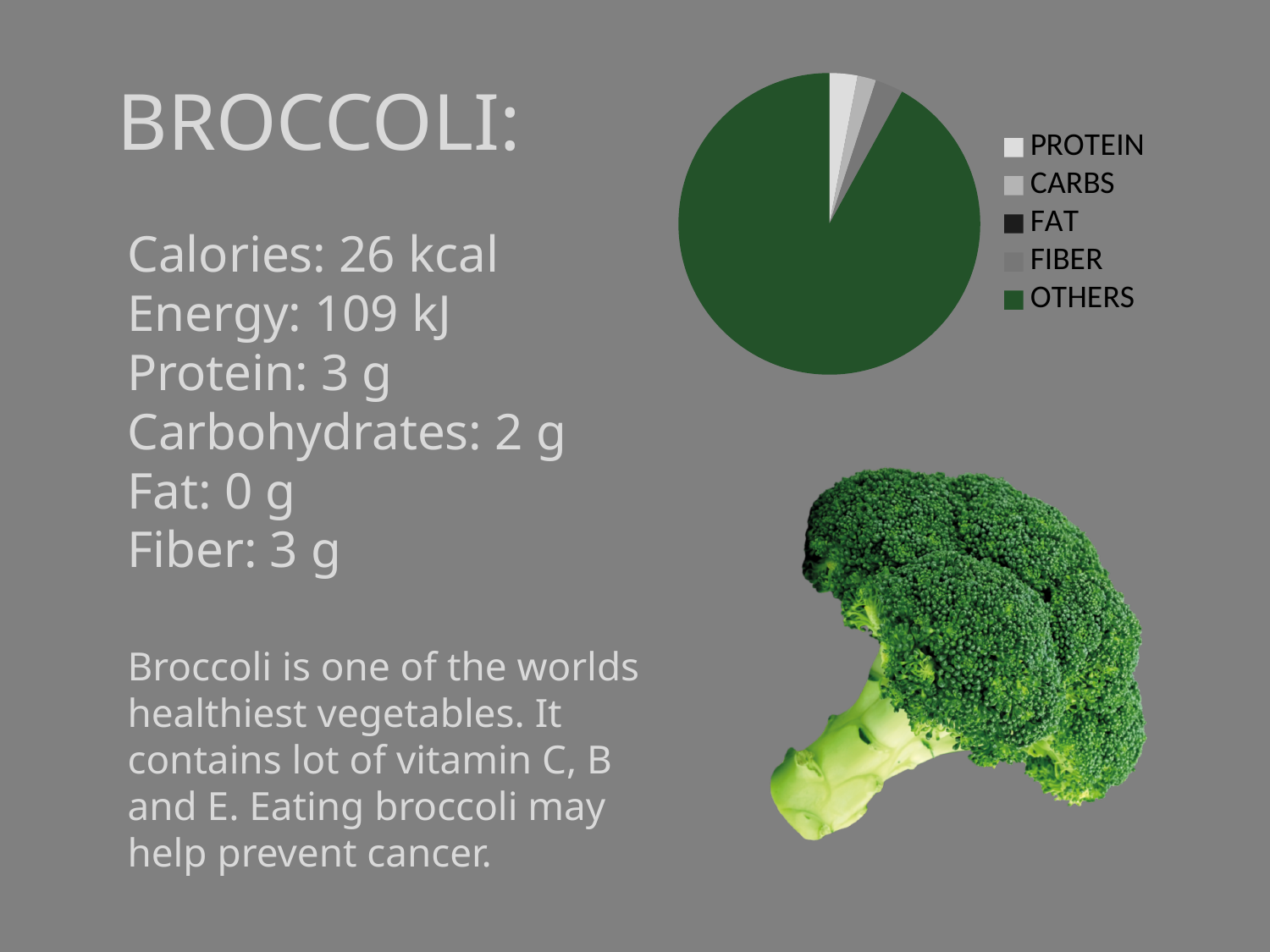
How many slices (categories) does the pie chart represent according to its legend? 5 Which slice is larger in the pie chart, OTHERS or PROTEIN? OTHERS Which legend entry is listed first in the pie chart's legend? PROTEIN Which slice is larger in the pie chart, OTHERS or CARBS? OTHERS What colour is the OTHERS slice in the pie chart? dark green Which category takes up the largest share of the pie chart? OTHERS What kind of chart is shown on the slide? pie chart How many entries does the legend of the pie chart list? 5